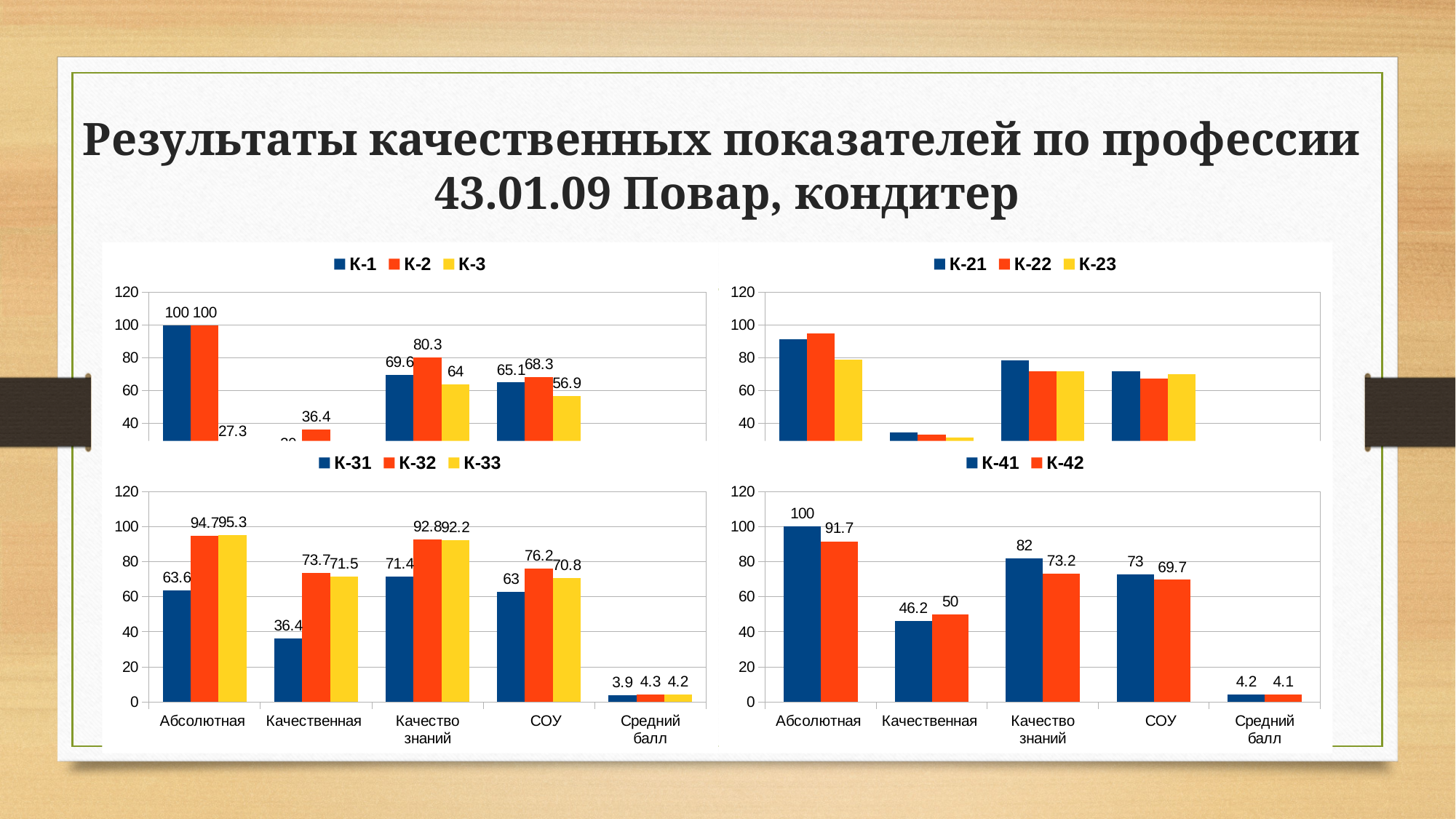
How many categories are shown on the x axis of the bottom-right chart (K-41, K-42)? 5 In the bottom-right chart (K-41, K-42), what is the value for K-42 in the category Качество знаний? 73.2 In the top-right chart (K-21, K-22, K-23), is the value for K-22 in the category Абсолютная greater or less than 80? greater In the bottom-left chart (K-31, K-32, K-33), what is the difference between K-32 and K-31 in the category Средний балл? 0.4 In the bottom-right chart (K-41, K-42), which category has the highest value for K-41? Абсолютная How many series does the legend of the bottom-left chart list? 3 In the bottom-left chart (K-31, K-32, K-33), which category has the lowest value for K-31? Средний балл In the bottom-left chart (K-31, K-32, K-33), what is the value for K-33 in the category Абсолютная? 95.3 In the bottom-right chart (K-41, K-42), what is the difference between K-41 and K-42 in the category Качество знаний? 8.8 In the bottom-left chart (K-31, K-32, K-33), which is larger in the category Качественная: K-32 or K-33? K-32 What type of chart is the bottom-right chart (K-41, K-42)? Bar chart In the top-left chart (K-1, K-2, K-3), what is the value for K-2 in the category Качество знаний? 80.3